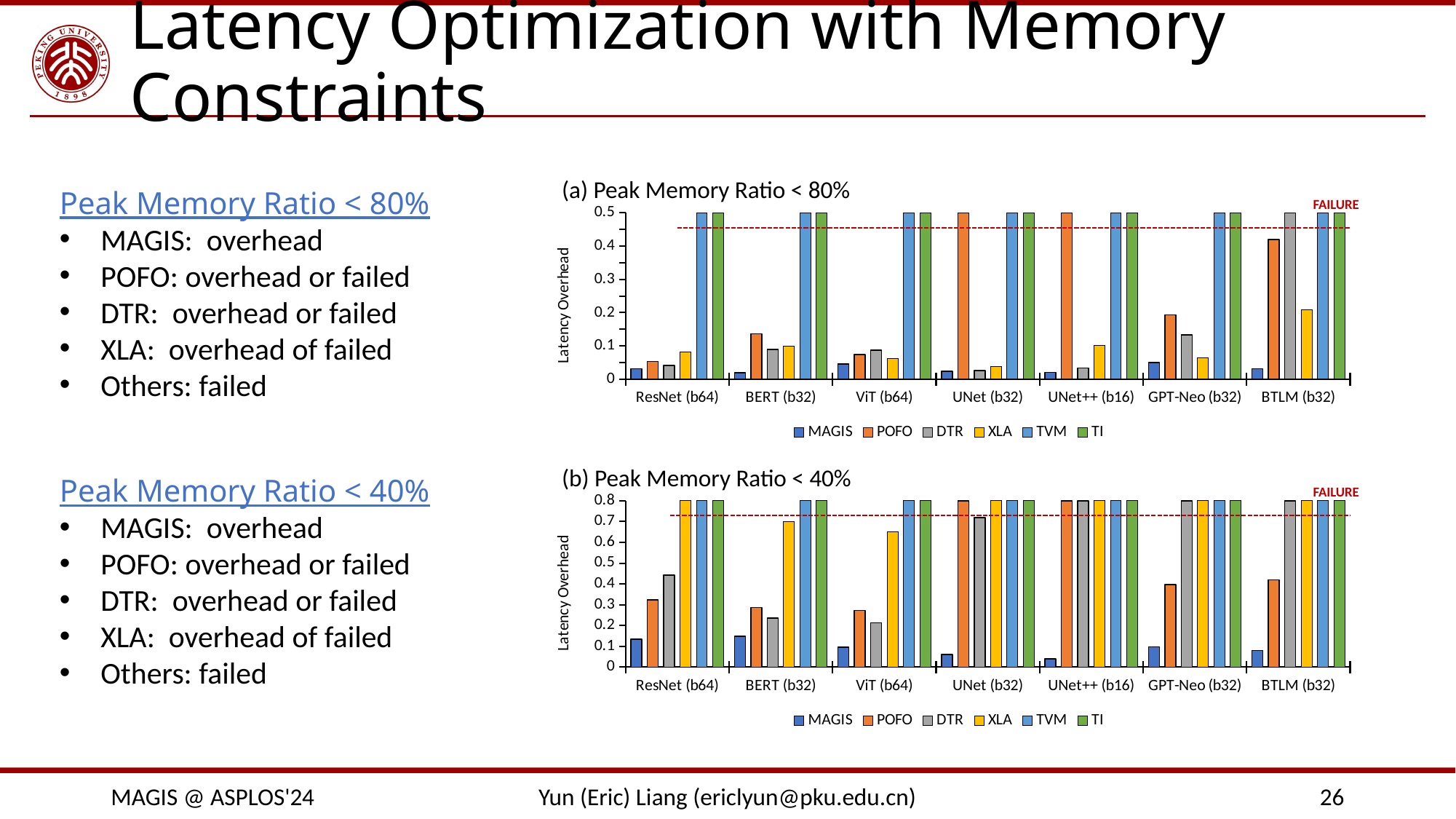
In chart (a) Peak Memory Ratio < 80%, is the POFO value for BTLM (b32) greater or less than 0.4? greater In chart (a) Peak Memory Ratio < 80%, which is larger for BERT (b32): the POFO value or the DTR value? POFO In chart (b) Peak Memory Ratio < 40%, which series has the lowest latency overhead for ResNet (b64)? MAGIS In chart (b) Peak Memory Ratio < 40%, which is larger for ResNet (b64): the DTR value or the POFO value? DTR How many series does the legend of chart (b) Peak Memory Ratio < 40% list? 6 In chart (b) Peak Memory Ratio < 40%, is the MAGIS value for ResNet (b64) greater or less than 0.1? greater What kind of chart is chart (a) Peak Memory Ratio < 80%? bar chart In chart (b) Peak Memory Ratio < 40%, is the DTR value for ResNet (b64) greater or less than 0.4? greater What is the y-axis label of chart (a) Peak Memory Ratio < 80%? Latency Overhead How many model categories are shown on the x axis of chart (a) Peak Memory Ratio < 80%? 7